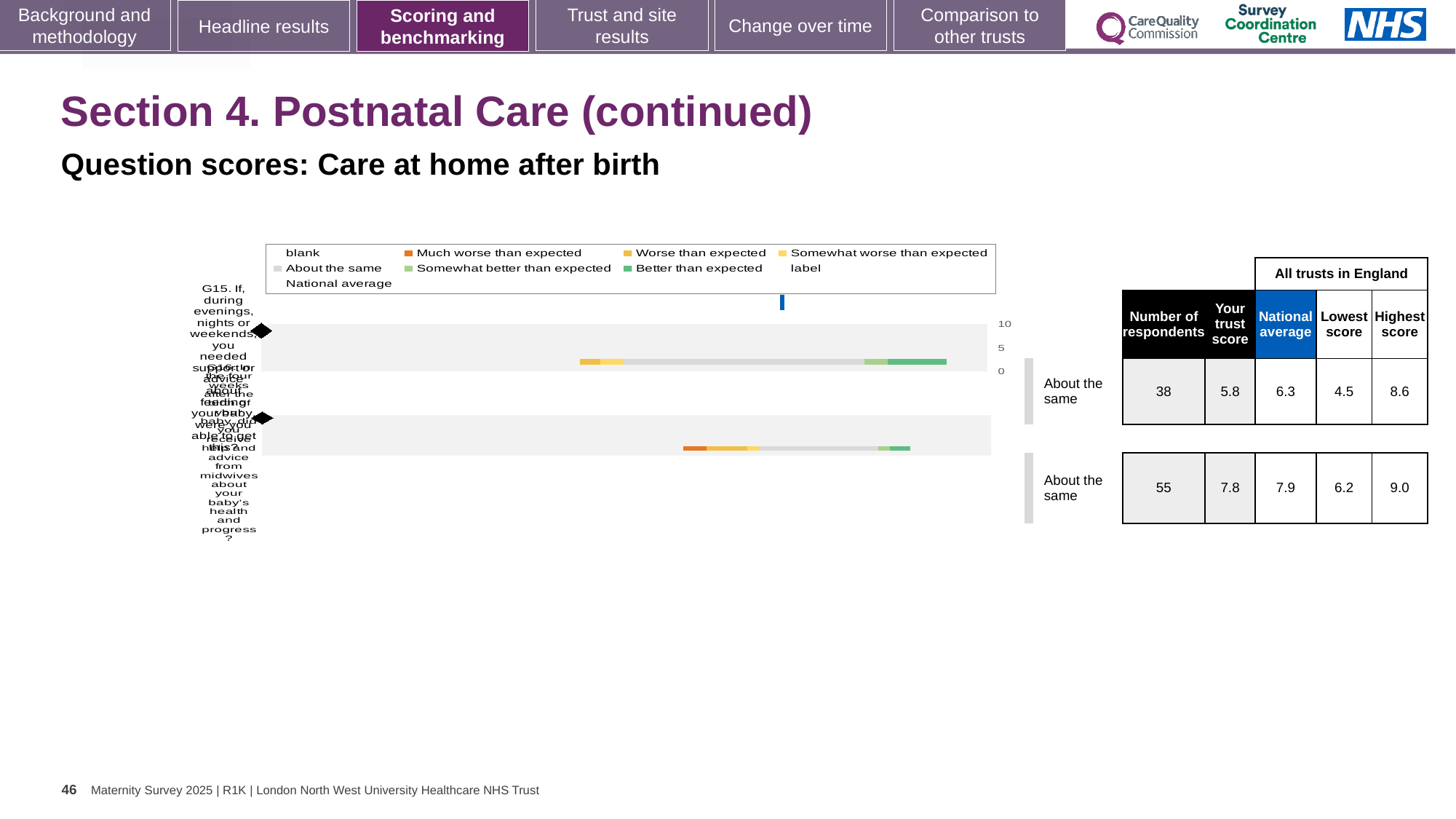
What is the difference between the national average and the trust score for the first (top) question row? 0.5 What is the 'National average' for the second (bottom) question row? 7.9 What is the 'Lowest score' for the second (bottom) question row? 6.2 Which question row has the larger number of respondents? the second (bottom) row What is the 'Highest score' for the first (top) question row? 8.6 What is the 'Your trust score' value for the first (top) question row? 5.8 How many respondents are listed for the first (top) question row? 38 How many question rows (bars) are plotted in the chart? 2 Which question row has the higher trust score, the first (top) or the second (bottom)? the second (bottom) row What benchmark category is shown next to both question rows? About the same What kind of chart is shown on the slide? bar chart What is the difference between the highest score and the lowest score for the second (bottom) question row? 2.8